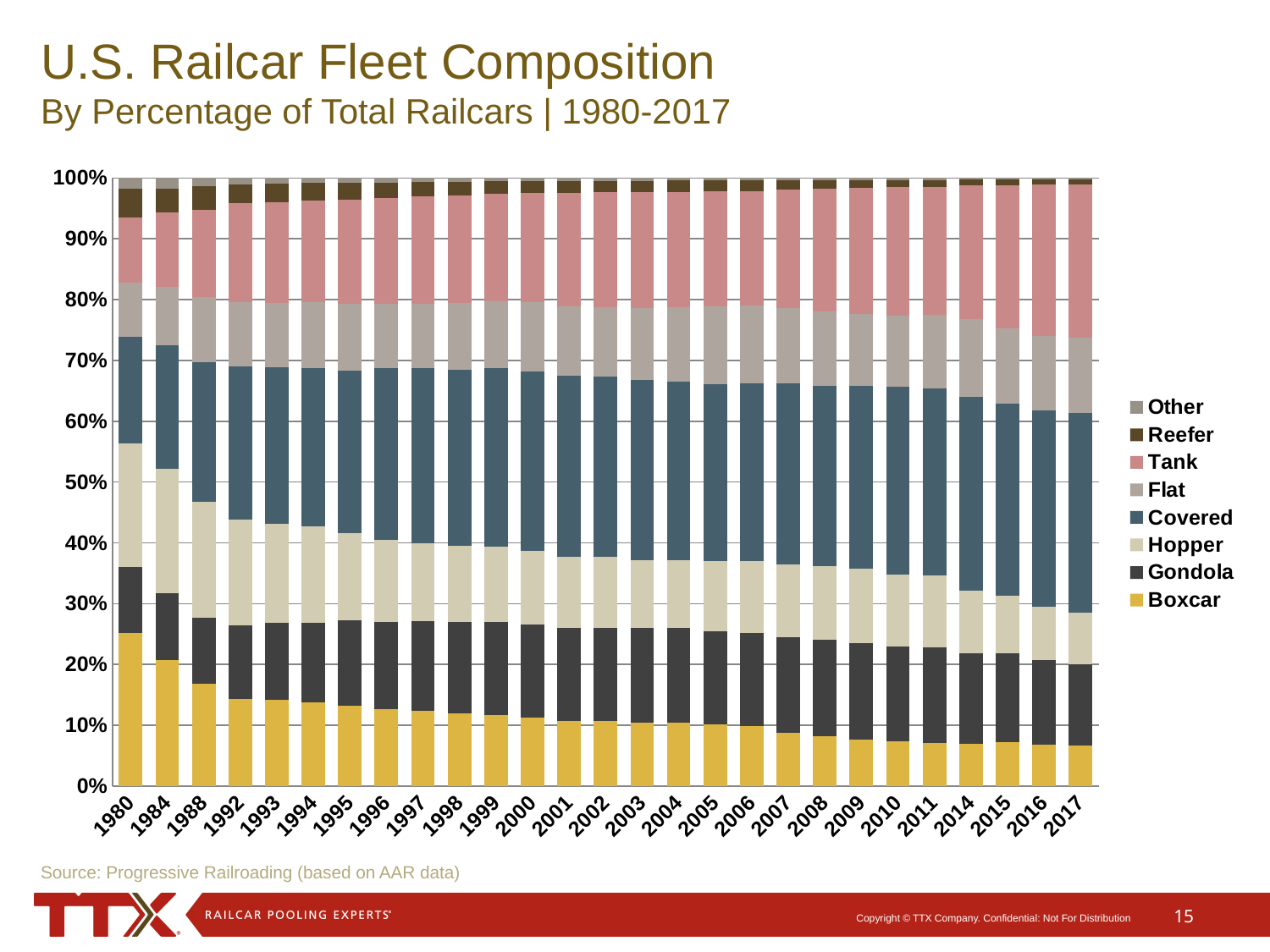
What source is cited for the chart data? Progressive Railroading (based on AAR data) Does the Tank share of the fleet rise or fall from 1980 to 2017? Rise What is the total of each stacked bar in the chart? 100% Is the Boxcar share in 2017 greater or less than 10%? less What is the title of the chart on the slide? U.S. Railcar Fleet Composition How many series does the chart's legend list? 8 How many years are shown along the x axis of the chart? 27 What kind of chart is shown on the slide? Stacked bar chart Does the Boxcar share of the fleet rise or fall from 1980 to 2017? Fall Is the Boxcar share in 1980 greater or less than 20%? greater Which year has the largest Boxcar share of the fleet? 1980 Which is larger, the Boxcar share in 1980 or the Boxcar share in 2017? 1980